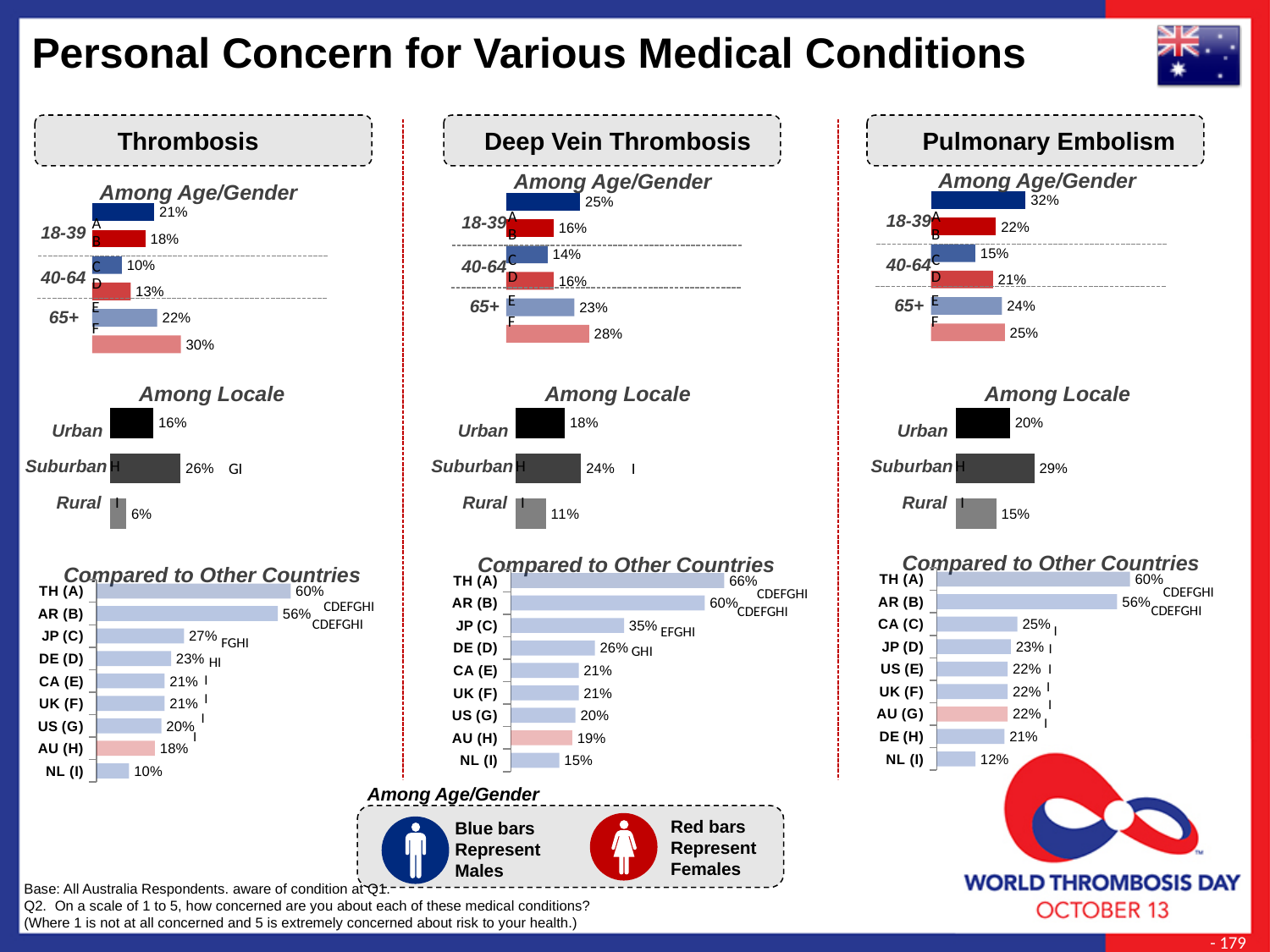
In the Deep Vein Thrombosis 'Among Age/Gender' chart, what is the value for bar F (65+ females)? 28% According to the legend at the bottom of the slide, what do the red bars in the 'Among Age/Gender' charts represent? Females In the Thrombosis 'Compared to Other Countries' chart, which country has the lowest value? NL (I) In the Deep Vein Thrombosis 'Compared to Other Countries' chart, which country has the highest value? TH (A) In the Pulmonary Embolism 'Compared to Other Countries' chart, what is the value for AU (G)? 22% In the Pulmonary Embolism 'Among Locale' chart, what is the difference between the Suburban and Rural values? 14% How many countries are shown in the Deep Vein Thrombosis 'Compared to Other Countries' chart? 9 In the Deep Vein Thrombosis 'Among Locale' chart, what is the value for Urban? 18% In the Pulmonary Embolism 'Among Age/Gender' chart, what is the difference between bar A (18-39 males) and bar B (18-39 females)? 10% In the Thrombosis 'Among Age/Gender' chart, which is larger: the value for bar A (18-39 males) or bar F (65+ females)? F (30%) What type of chart is used for the 'Among Locale' sections on this slide? Bar chart In the Thrombosis 'Among Locale' chart, what is the value for Rural? 6%